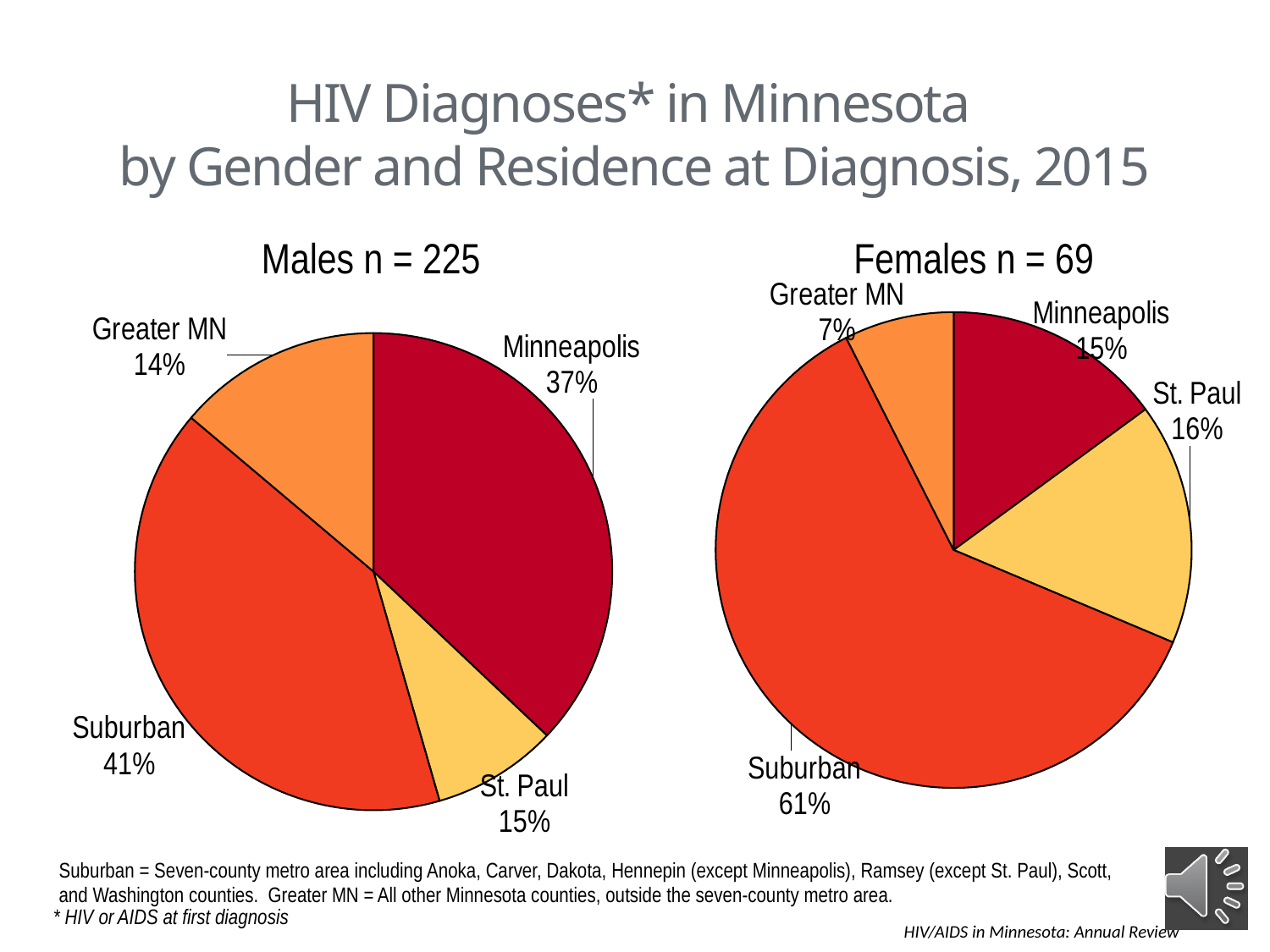
What type of chart is used for Females n = 69? Pie chart In the Males n = 225 pie chart, which residence category has the largest share? Suburban In the Females n = 69 pie chart, which is larger, Suburban or St. Paul? Suburban What is the title of the slide containing the two pie charts? HIV Diagnoses* in Minnesota by Gender and Residence at Diagnosis, 2015 In the Males n = 225 pie chart, what share of the pie is Greater MN? 14% In the Females n = 69 pie chart, which residence category has the smallest share? Greater MN In the Males n = 225 pie chart, what is the difference in percentage points between Minneapolis and St. Paul? 22 In the Males n = 225 pie chart, what percentage is Suburban? 41% In the Males n = 225 pie chart, what colour is the Minneapolis slice? Dark red How many slices does the Males n = 225 pie chart have? 4 In the Females n = 69 pie chart, what percentage is Minneapolis? 15% In the Females n = 69 pie chart, what is the combined percentage of Minneapolis and St. Paul? 31%